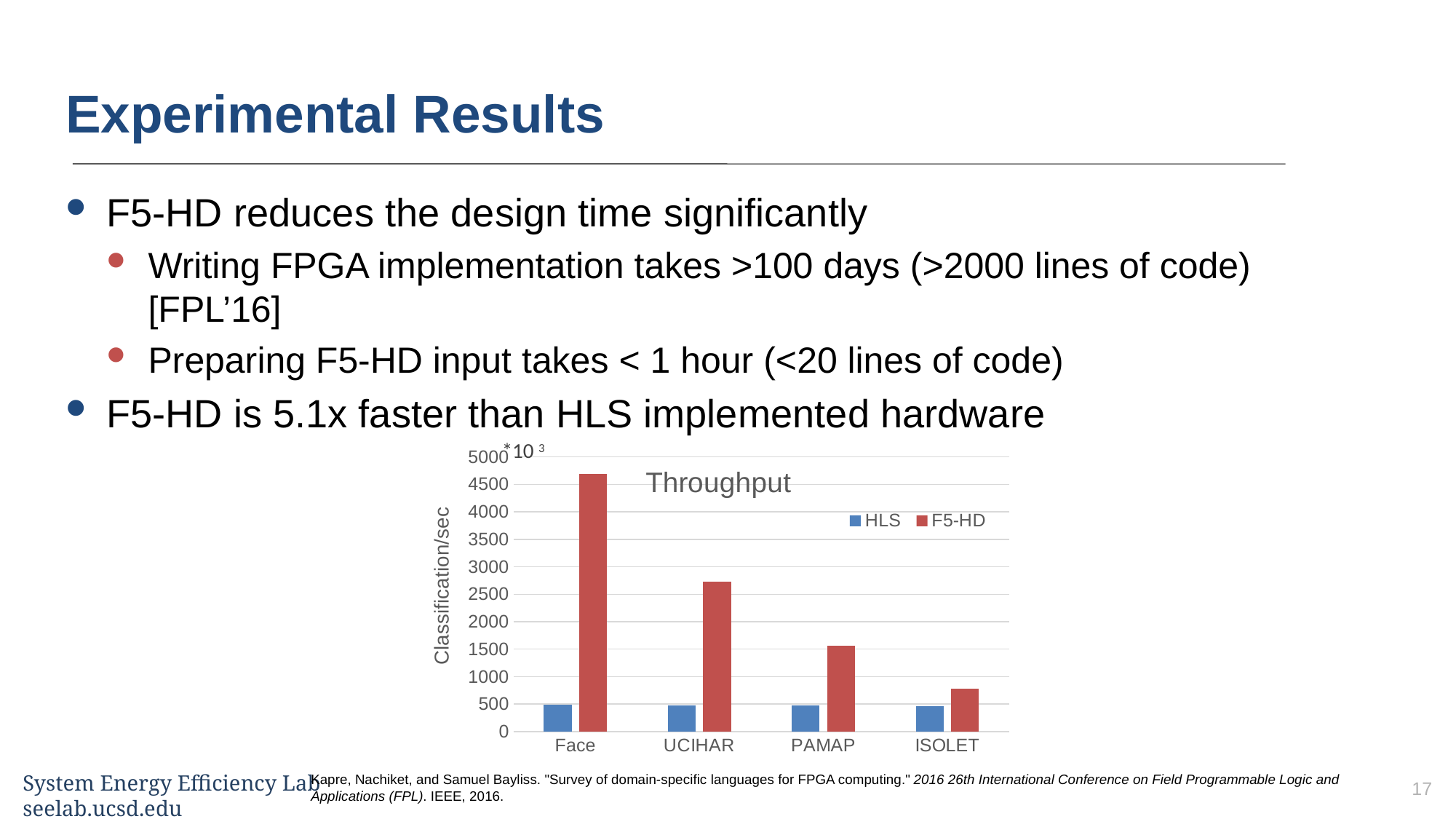
How many categories are shown on the x axis of the chart? 4 How many series does the chart legend list? 2 Which category has the highest F5-HD value? Face For Face, which is larger, the HLS value or the F5-HD value? F5-HD What kind of chart is shown on the slide? bar chart Is the F5-HD value for ISOLET greater or less than 1000? less Is the F5-HD value for Face greater or less than 4500? greater Which category has the lowest F5-HD value? ISOLET What is the label on the y axis of the chart? Classification/sec Is the F5-HD value for UCIHAR greater or less than 2500? greater What is the title of the chart? Throughput Do the F5-HD values rise or fall from Face to ISOLET along the x axis? fall